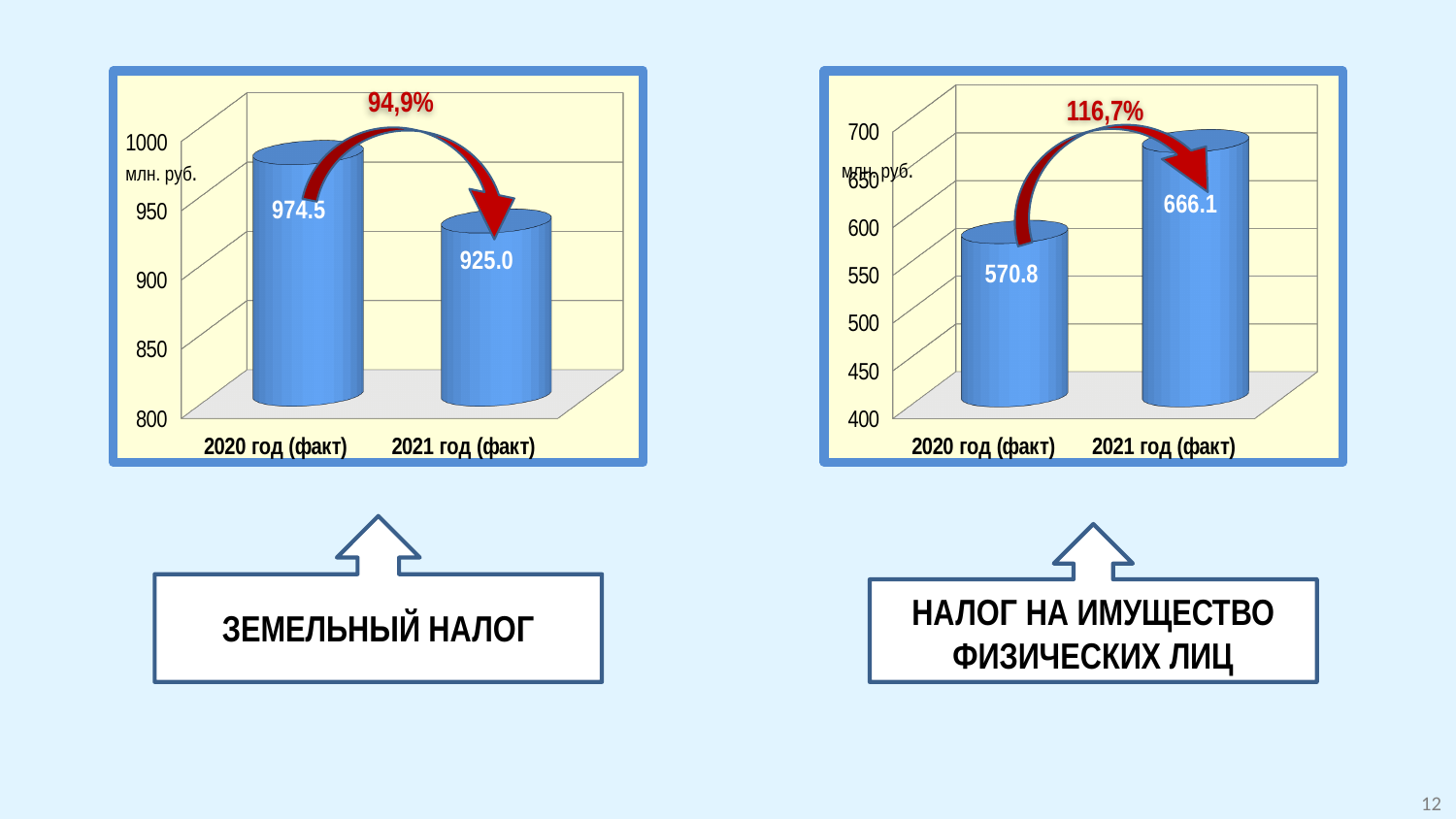
On the left chart (ЗЕМЕЛЬНЫЙ НАЛОГ), what is the difference between the 2020 and 2021 values? 49.5 On the left chart (ЗЕМЕЛЬНЫЙ НАЛОГ), which year has the higher value? 2020 год (факт) On the right chart (НАЛОГ НА ИМУЩЕСТВО ФИЗИЧЕСКИХ ЛИЦ), what percentage is shown in red above the bars? 116,7% On the right chart (НАЛОГ НА ИМУЩЕСТВО ФИЗИЧЕСКИХ ЛИЦ), do the values rise or fall from 2020 to 2021? rise On the right chart (НАЛОГ НА ИМУЩЕСТВО ФИЗИЧЕСКИХ ЛИЦ), which year has the lower value? 2020 год (факт) On the left chart (ЗЕМЕЛЬНЫЙ НАЛОГ), what is the value for 2020 год (факт)? 974.5 On the right chart (НАЛОГ НА ИМУЩЕСТВО ФИЗИЧЕСКИХ ЛИЦ), what is the value for 2020 год (факт)? 570.8 On the left chart (ЗЕМЕЛЬНЫЙ НАЛОГ), do the values rise or fall from 2020 to 2021? fall On the left chart (ЗЕМЕЛЬНЫЙ НАЛОГ), what is the value for 2021 год (факт)? 925.0 On the right chart (НАЛОГ НА ИМУЩЕСТВО ФИЗИЧЕСКИХ ЛИЦ), what is the difference between the 2021 and 2020 values? 95.3 What kind of chart is the left chart (ЗЕМЕЛЬНЫЙ НАЛОГ)? bar chart On the right chart (НАЛОГ НА ИМУЩЕСТВО ФИЗИЧЕСКИХ ЛИЦ), what is the value for 2021 год (факт)? 666.1